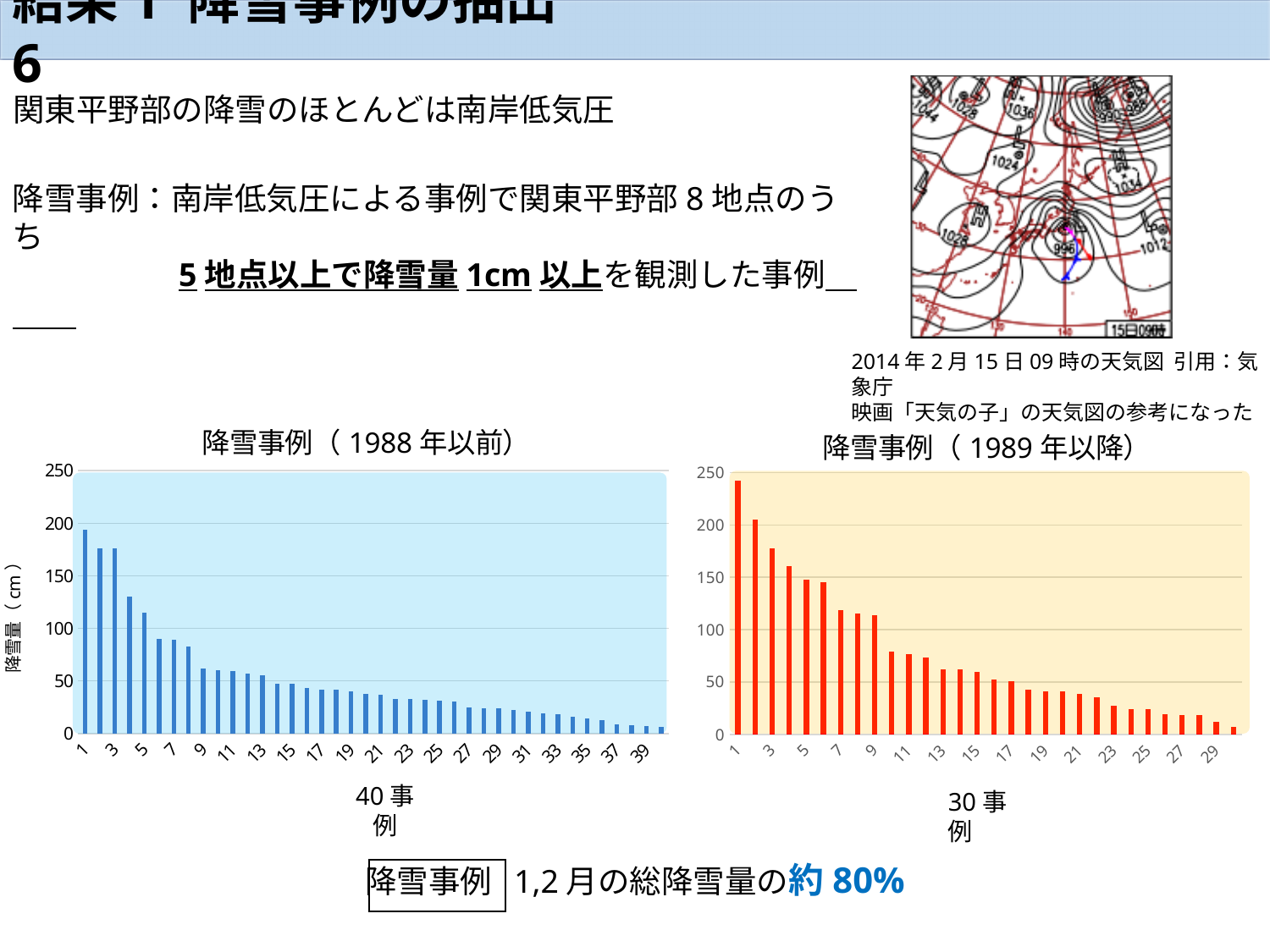
In the right chart titled 降雪事例（1989年以降）, which case number has the highest snowfall? 1 What kind of chart is the left chart titled 降雪事例（1988年以前）? bar chart What colour are the bars in the right chart titled 降雪事例（1989年以降）? red How many cases (事例) are plotted in the right chart titled 降雪事例（1989年以降）? 30 What is the label on the y axis of the left chart titled 降雪事例（1988年以前）? 降雪量（cm） In the right chart titled 降雪事例（1989年以降）, is the value for case 1 greater or less than 200? greater In the right chart titled 降雪事例（1989年以降）, is the value for case 10 greater or less than 100? less In the left chart titled 降雪事例（1988年以前）, is the value for case 1 greater or less than 150? greater In the left chart titled 降雪事例（1988年以前）, do the values rise or fall as the case number increases along the x axis? fall In the left chart titled 降雪事例（1988年以前）, which case number has the lowest snowfall? 40 How many cases (事例) are plotted in the left chart titled 降雪事例（1988年以前）? 40 In the left chart titled 降雪事例（1988年以前）, which is larger, the value for case 1 or the value for case 5? case 1